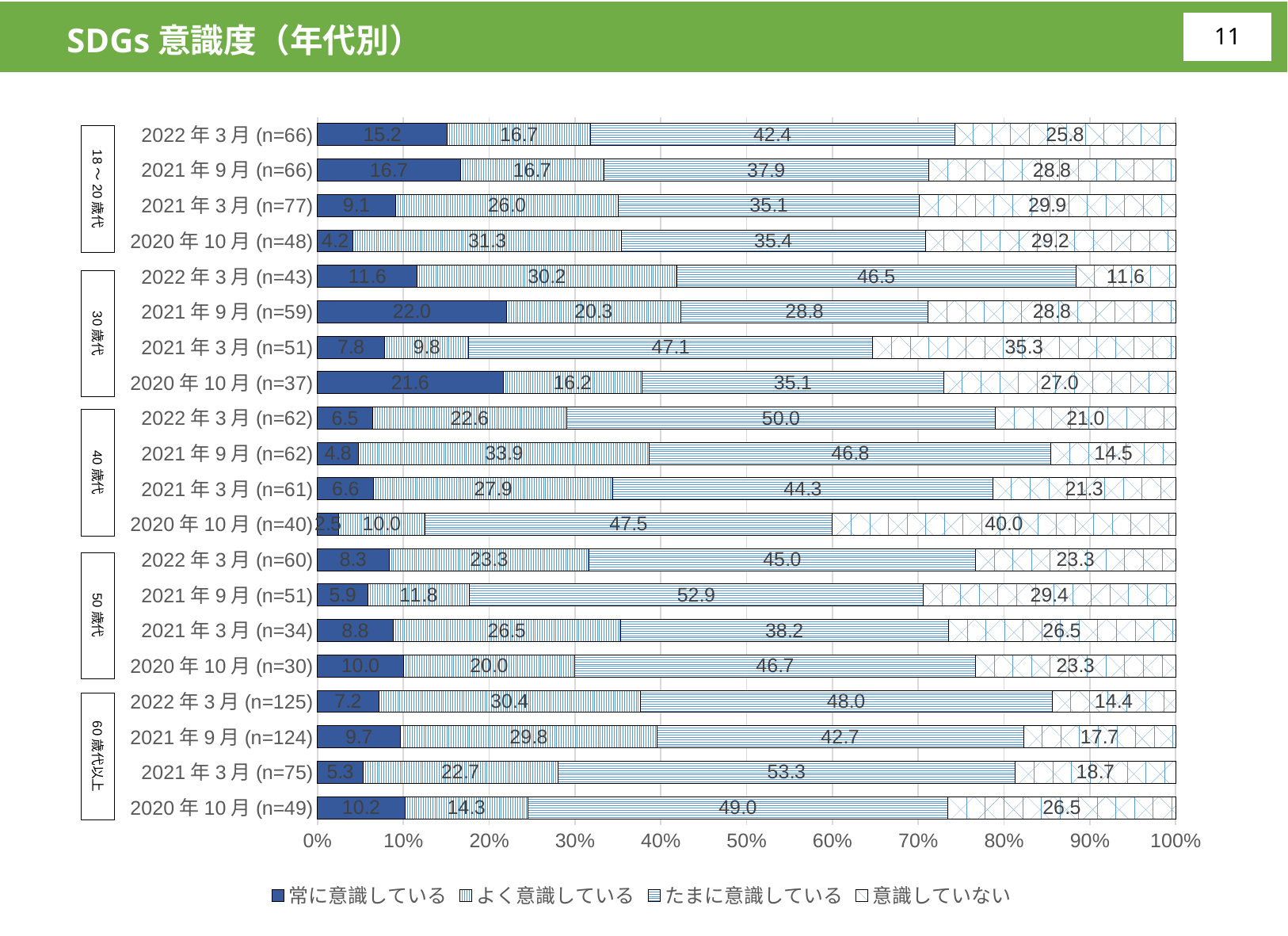
For 60歳代以上, which has the larger たまに意識している value: 2022年3月 (n=125) or 2021年9月 (n=124)? 2022年3月 (n=125) How many series does the legend list? 4 What kind of chart is shown on the slide? Stacked bar chart Which bar has the lowest value for 常に意識している? 40歳代 2020年10月 (n=40) What is the difference in 意識していない between 18～20歳代 2021年9月 (n=66) and 18～20歳代 2022年3月 (n=66)? 3.0 What is the value of よく意識している for 50歳代 2021年9月 (n=51)? 11.8 What is the value of 意識していない for 40歳代 2020年10月 (n=40)? 40.0 What is the value of 常に意識している for 18～20歳代 2022年3月 (n=66)? 15.2 Which bar has the highest value for 意識していない? 40歳代 2020年10月 (n=40) How many bars are plotted in the chart? 20 What is the value of たまに意識している for 40歳代 2022年3月 (n=62)? 50.0 What is the value of たまに意識している for 60歳代以上 2021年3月 (n=75)? 53.3